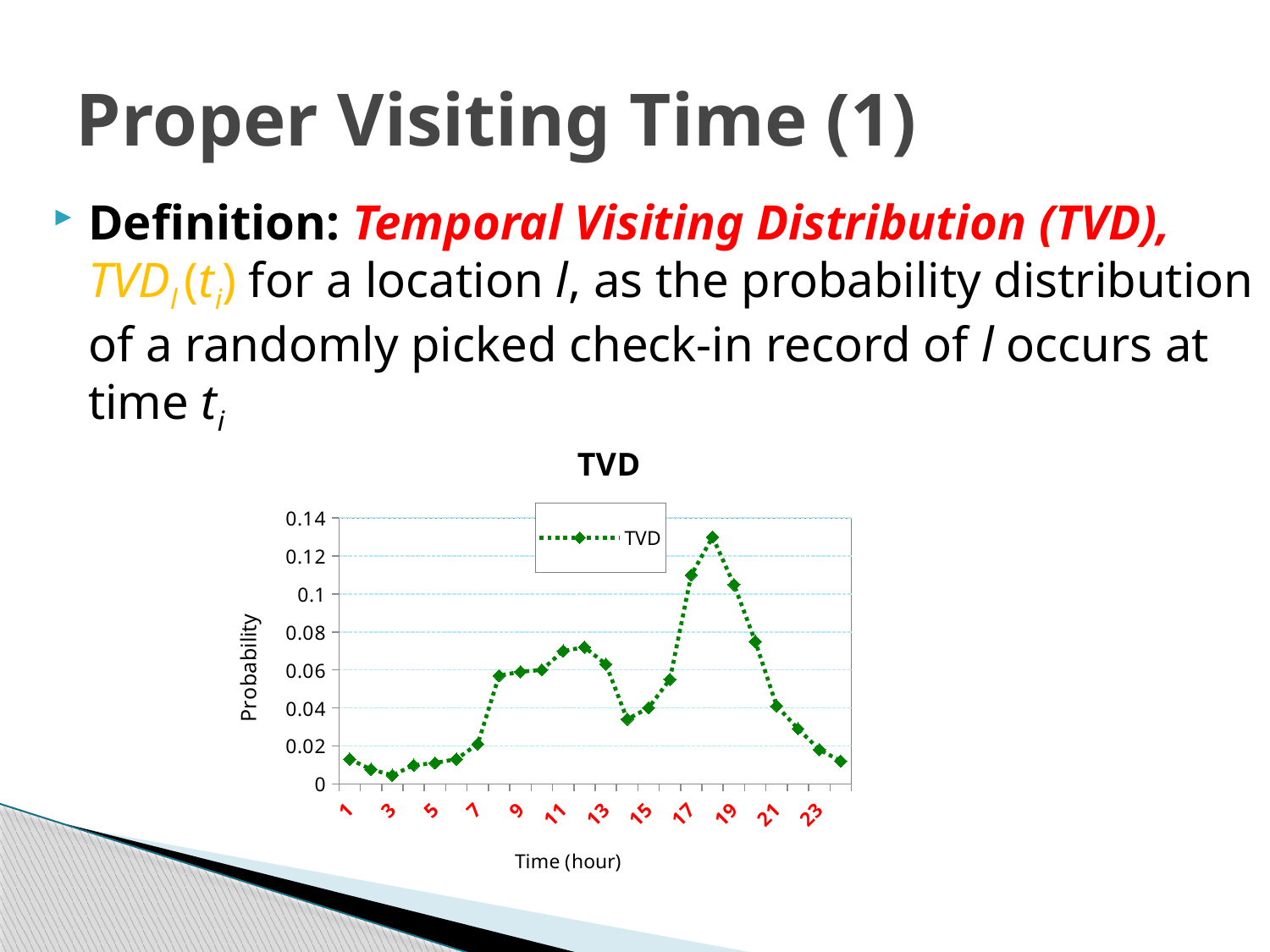
How many series does the chart legend list? 1 Is the value for hour 9 greater or less than 0.04? greater What is the title of the chart? TVD Is the value for hour 12 greater or less than 0.08? less How many data points are plotted on the TVD line? 24 What is the label of the x axis of the chart? Time (hour) Which has the larger value, hour 10 or hour 14? hour 10 Is the value for hour 21 greater or less than 0.06? less At which hour does the TVD line reach its highest value? 18 What kind of chart is shown on the slide? line chart Do the values rise or fall from hour 18 to hour 24? fall